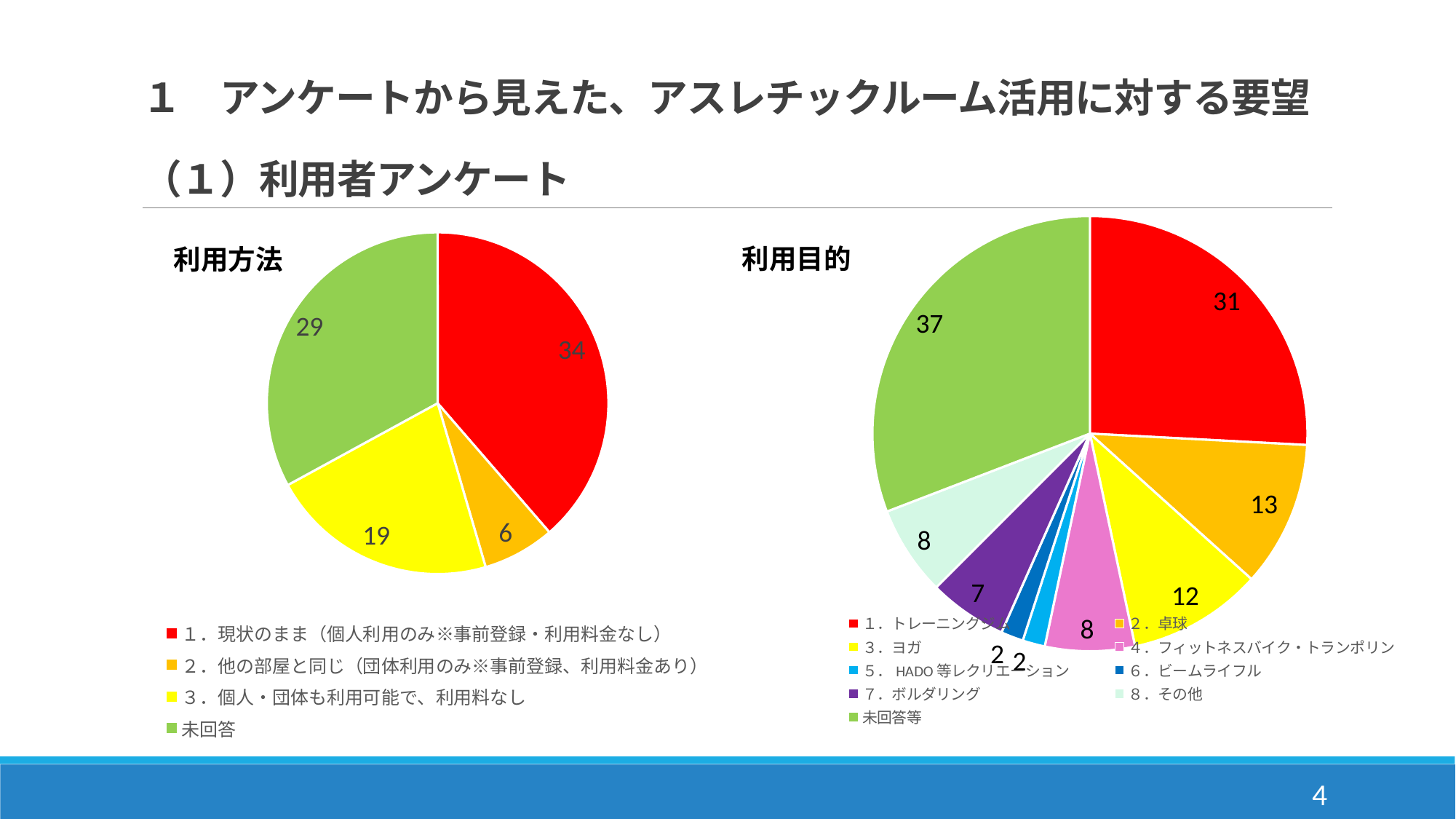
In the 利用目的 chart, what is the value for 3．ヨガ? 12 How many categories does the legend of the 利用目的 chart list? 9 In the 利用方法 chart, what is the difference between the values for 1．現状のまま and 3．個人・団体も利用可能で、利用料なし? 15 In the 利用方法 chart, what is the value for 2．他の部屋と同じ（団体利用のみ※事前登録、利用料金あり）? 6 In the 利用目的 chart, which is larger, 2．卓球 or 8．その他? 2．卓球 What type of chart is the 利用方法 chart? pie chart In the 利用方法 chart, what is the value for 未回答? 29 In the 利用方法 chart, which category has the largest slice? 1．現状のまま（個人利用のみ※事前登録・利用料金なし） In the 利用目的 chart, which category has the largest slice? 未回答等 In the 利用目的 chart, what is the difference between the values for 未回答等 and 2．卓球? 24 In the 利用目的 chart, what is the value for 7．ボルダリング? 7 How many categories does the legend of the 利用方法 chart list? 4